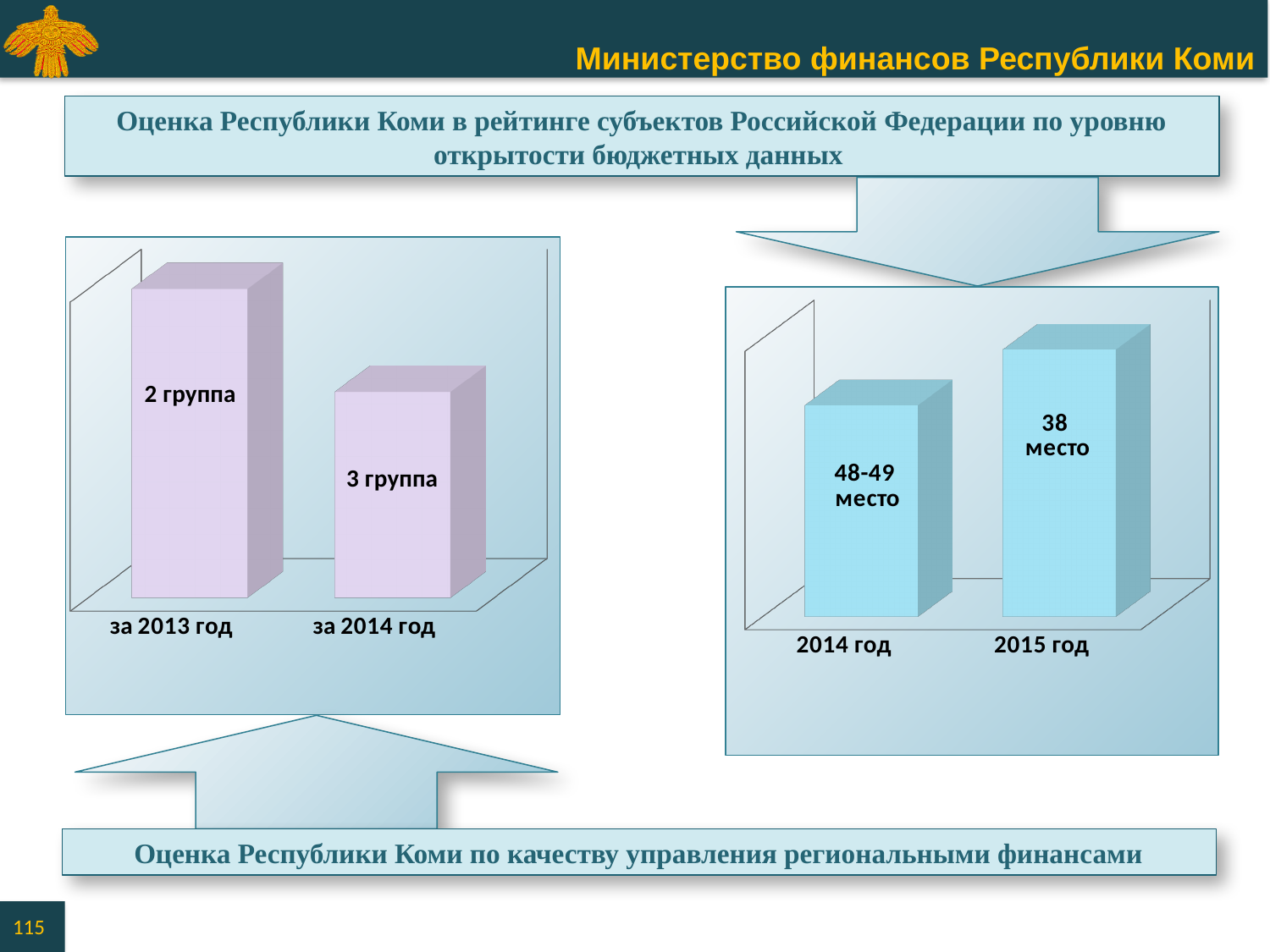
On the right chart, which year has the taller bar, 2014 год or 2015 год? 2015 год What kind of chart is the left chart? bar chart How many bars does the right chart have? 2 On the right chart, what place is shown for 2014 год? 48-49 место On the right chart, what place is shown for 2015 год? 38 место On the left chart, what label is shown on the bar for 'за 2013 год'? 2 группа What is the title of the box connected by an arrow to the left chart? Оценка Республики Коми по качеству управления региональными финансами On the left chart, what label is shown on the bar for 'за 2014 год'? 3 группа Which years are shown on the x axis of the right chart? 2014 год, 2015 год How many bars does the left chart have? 2 On the left chart, which year has the taller bar, за 2013 год or за 2014 год? за 2013 год What kind of chart is the right chart? bar chart